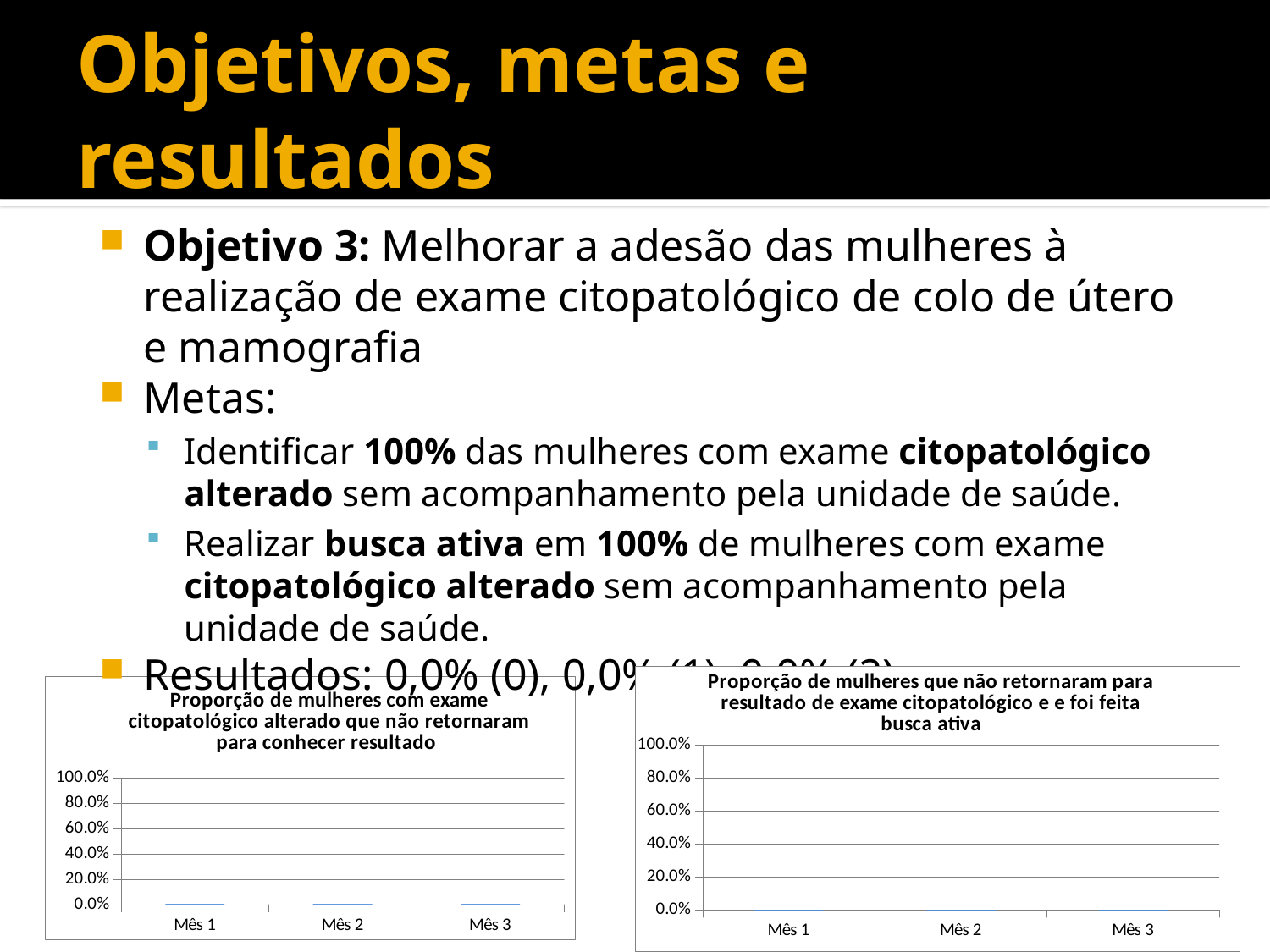
In the left chart, 'Proporção de mulheres com exame citopatológico alterado que não retornaram para conhecer resultado', is the value for Mês 3 greater or less than 40.0%? less What kind of chart is the left chart, 'Proporção de mulheres com exame citopatológico alterado que não retornaram para conhecer resultado'? bar chart What is the label of the first category on the x axis of the right chart, 'Proporção de mulheres que não retornaram para resultado de exame citopatológico e e foi feita busca ativa'? Mês 1 How many categories are shown on the x axis of the right chart, 'Proporção de mulheres que não retornaram para resultado de exame citopatológico e e foi feita busca ativa'? 3 What is the value for Mês 2 in the left chart, 'Proporção de mulheres com exame citopatológico alterado que não retornaram para conhecer resultado'? 0.0% How many charts are shown on the slide? 2 What is the highest value shown on the y axis of the right chart, 'Proporção de mulheres que não retornaram para resultado de exame citopatológico e e foi feita busca ativa'? 100.0% In the left chart, 'Proporção de mulheres com exame citopatológico alterado que não retornaram para conhecer resultado', is the value for Mês 1 greater or less than 20.0%? less In the right chart, 'Proporção de mulheres que não retornaram para resultado de exame citopatológico e e foi feita busca ativa', is the value for Mês 2 greater or less than 20.0%? less How many categories are shown on the x axis of the left chart, 'Proporção de mulheres com exame citopatológico alterado que não retornaram para conhecer resultado'? 3 Do the values in the left chart, 'Proporção de mulheres com exame citopatológico alterado que não retornaram para conhecer resultado', rise, fall or stay flat from Mês 1 to Mês 3? stay flat